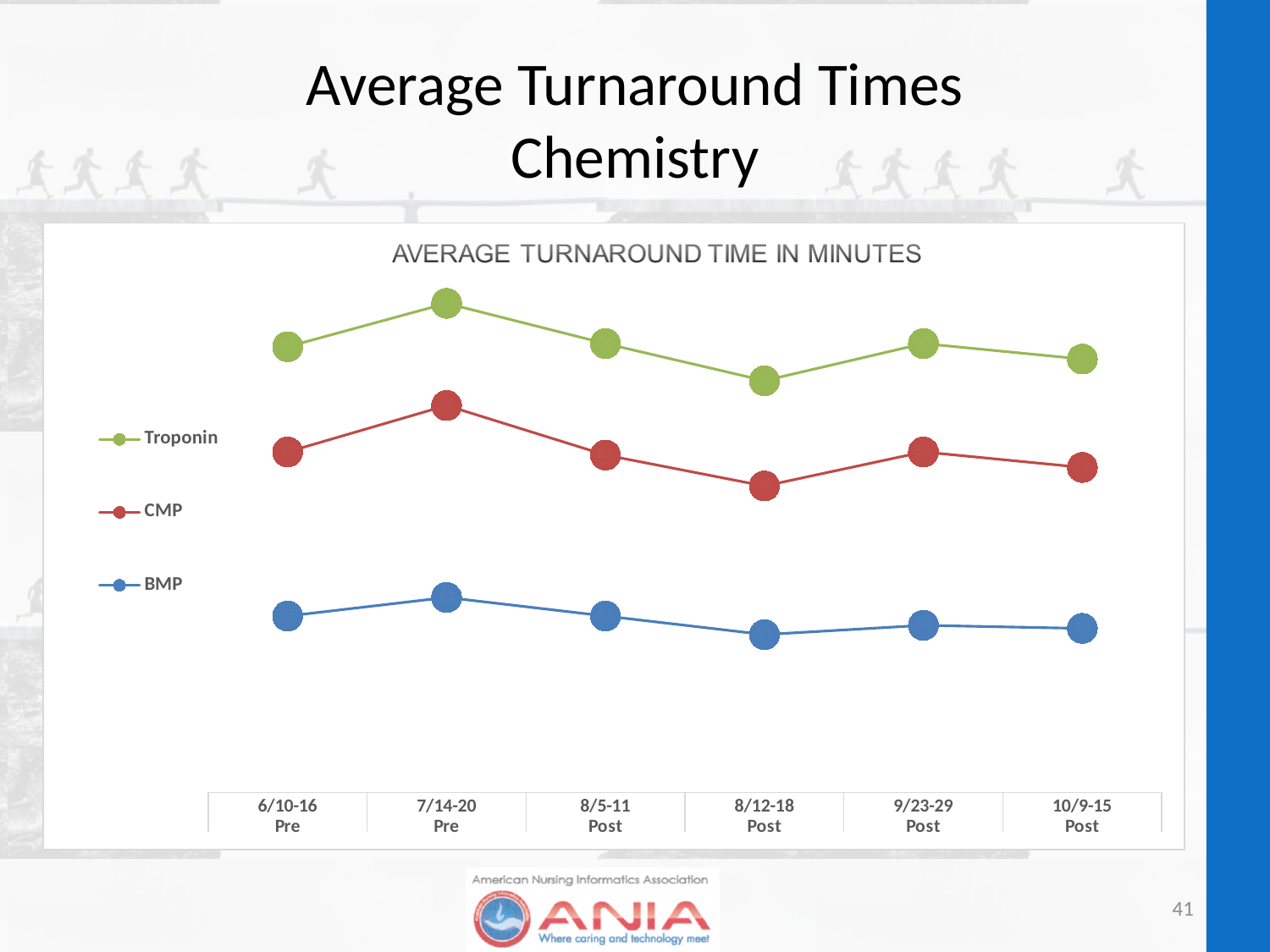
In which period is the BMP turnaround time highest? 7/14-20 Pre Which series is plotted in green? Troponin How many series does the legend list? 3 How many time periods are shown along the x axis? 6 What is the title printed above the chart? AVERAGE TURNAROUND TIME IN MINUTES In which period is the CMP turnaround time lowest? 8/12-18 Post What kind of chart is shown on the slide? Line chart Does the BMP turnaround time rise or fall from 6/10-16 Pre to 7/14-20 Pre? Rise